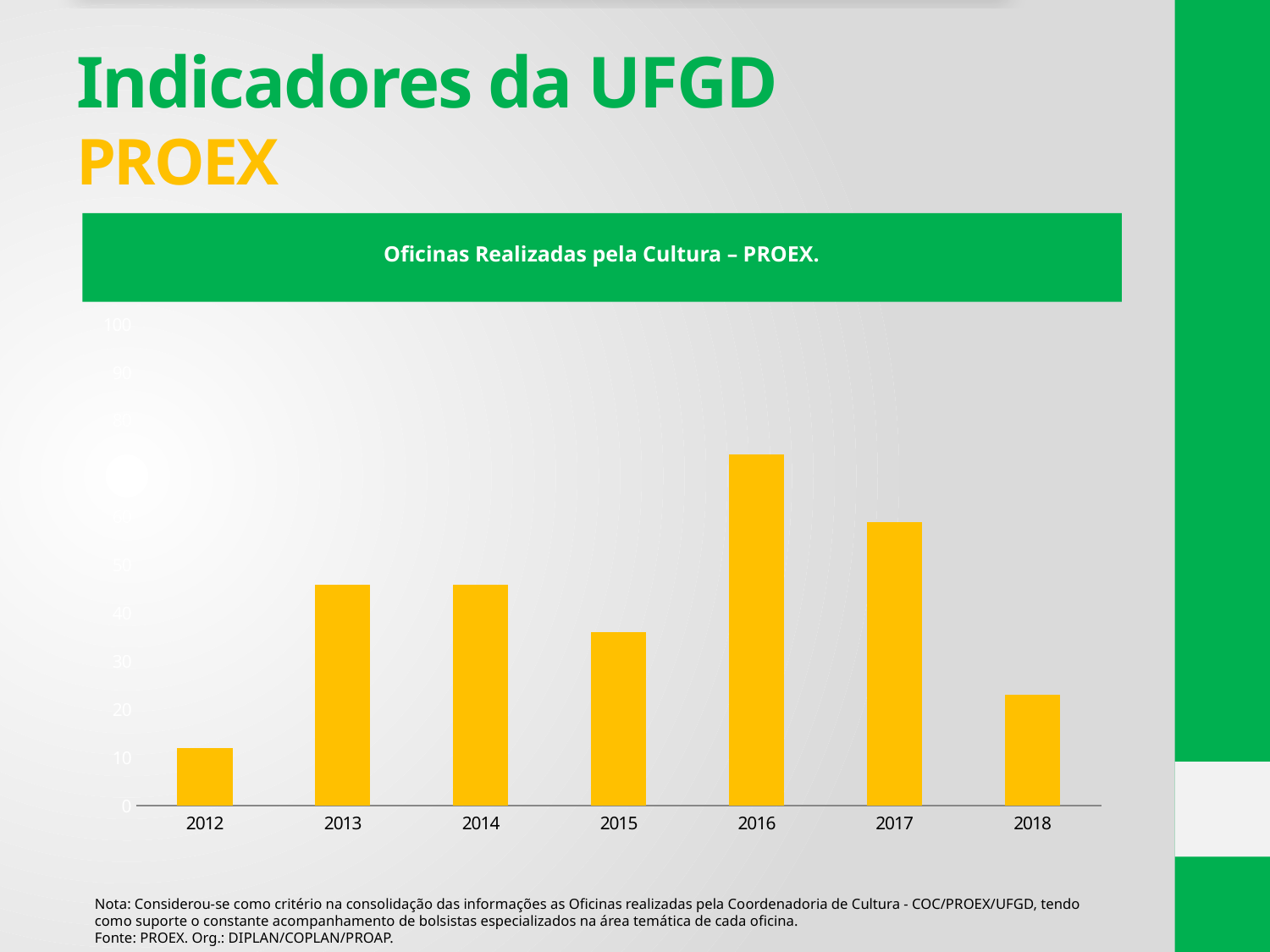
Which is larger, the value for 2016 or the value for 2017? 2016 Which year has the highest bar? 2016 Is the value for 2018 greater or less than 30? less What kind of chart is shown on the slide? bar chart Is the value for 2012 greater or less than 20? less How many years are shown on the x axis of the chart? 7 From 2016 to 2018, do the values rise or fall? fall Which is larger, the value for 2015 or the value for 2018? 2015 Which year has the lowest bar? 2012 Is the value for 2016 greater or less than 60? greater What is the title of the chart? Oficinas Realizadas pela Cultura – PROEX.